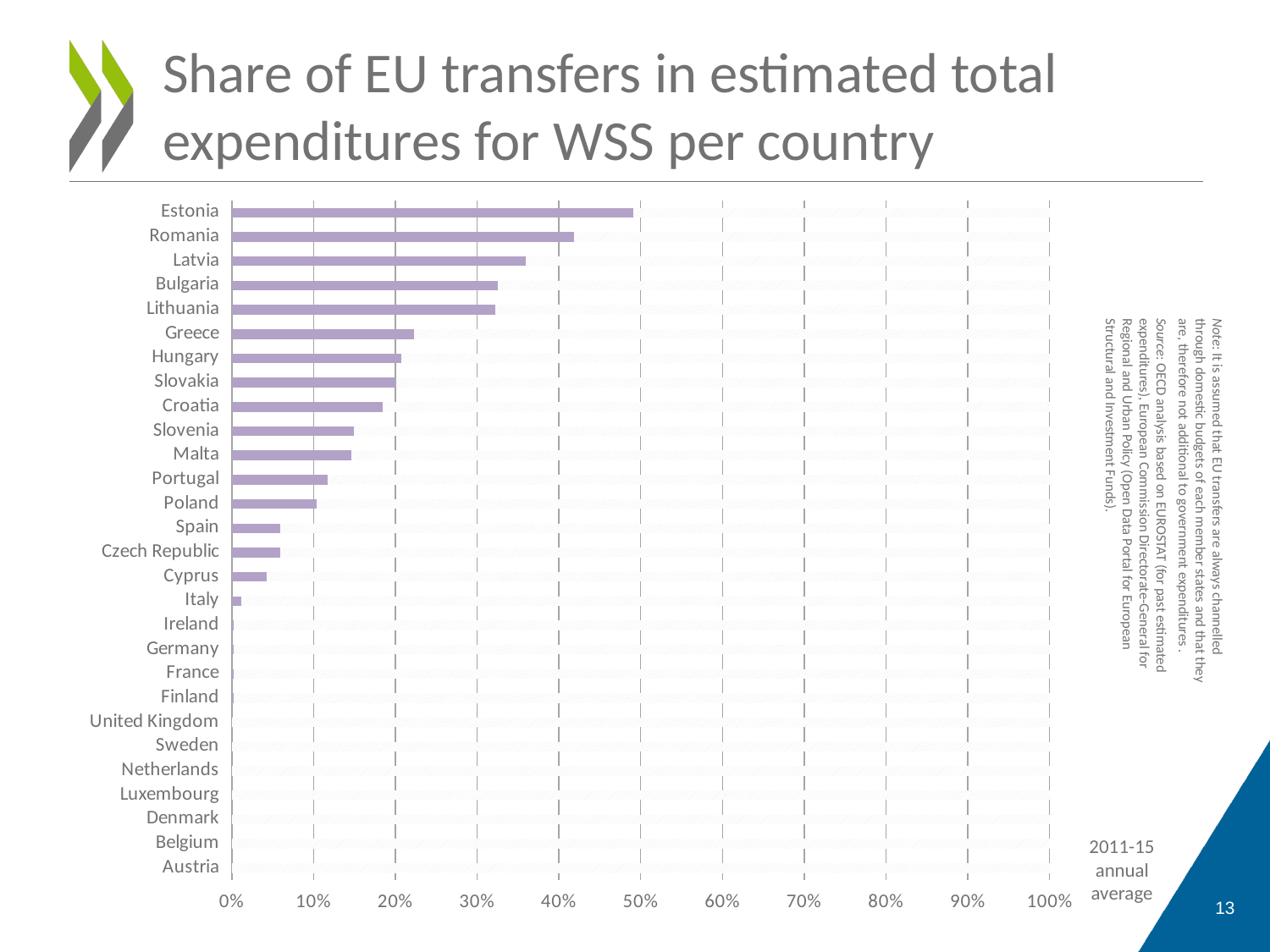
What kind of chart is shown on the slide? bar chart How many countries are listed on the chart? 28 Is the value for Croatia greater or less than 20%? less Which country has the highest share of EU transfers in estimated total expenditures for WSS? Estonia Is the value for Bulgaria greater or less than 30%? greater What period do the values on the chart represent, according to the label next to the chart? 2011-15 annual average Is the value for Slovenia greater or less than 10%? greater Which has a larger share of EU transfers, Greece or Portugal? Greece Which has a larger share of EU transfers, Romania or Latvia? Romania